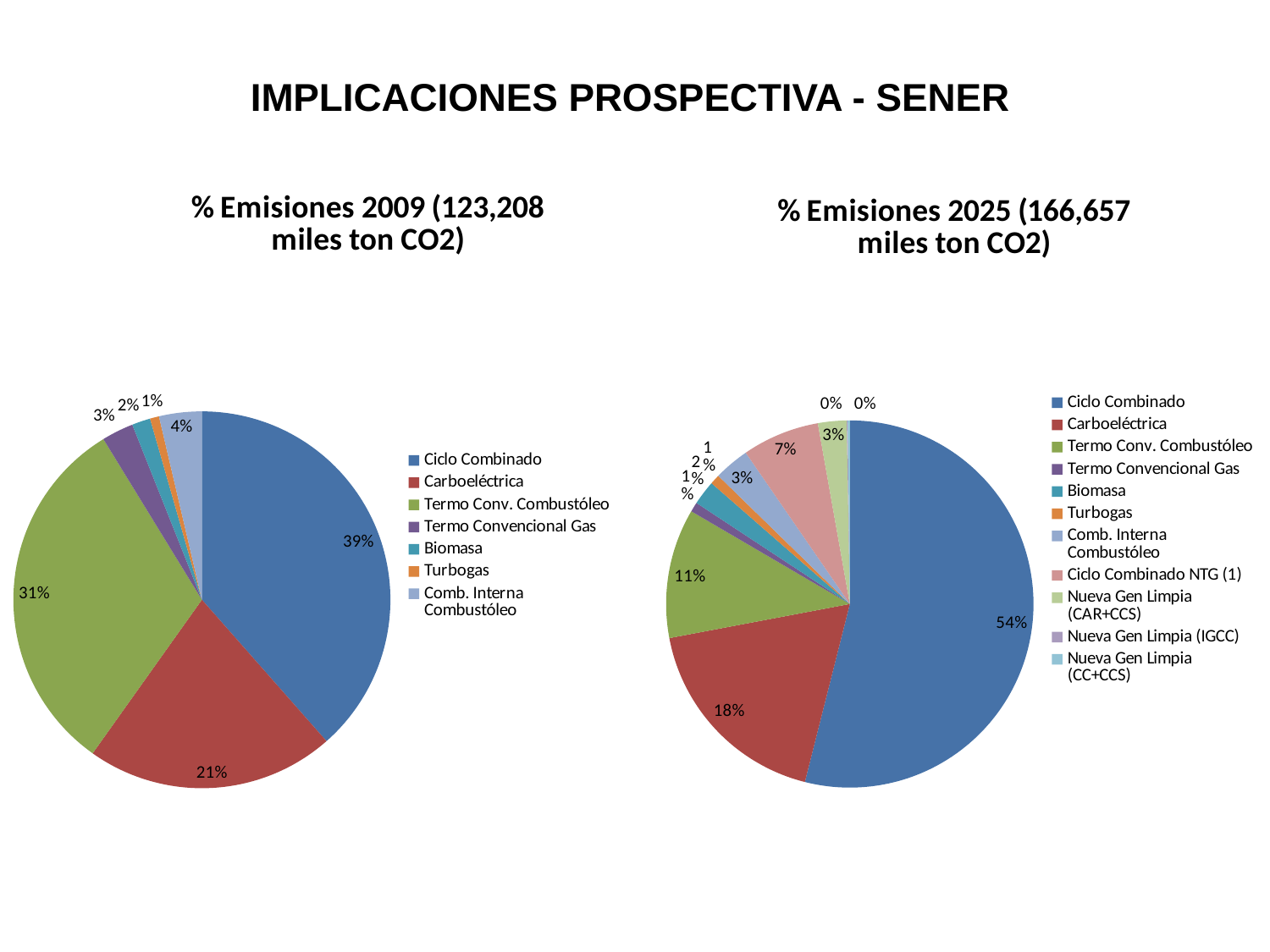
In the '% Emisiones 2009' pie chart, what share does Ciclo Combinado have? 39% In the '% Emisiones 2025' pie chart, what share does Ciclo Combinado NTG (1) have? 7% In the '% Emisiones 2025' pie chart, what share does Carboeléctrica have? 18% In the '% Emisiones 2009' pie chart, which category has the largest share? Ciclo Combinado What type of chart is used on the left side of the slide? Pie chart In the '% Emisiones 2025' pie chart, which is larger: the share of Carboeléctrica or the share of Termo Conv. Combustóleo? Carboeléctrica How many entries does the legend of the '% Emisiones 2025' pie chart list? 11 In the '% Emisiones 2009' pie chart, which category has the smallest share? Turbogas In the '% Emisiones 2009' pie chart, what share does Termo Conv. Combustóleo have? 31% In the '% Emisiones 2025' pie chart, what share does Ciclo Combinado have? 54% In the '% Emisiones 2009' pie chart, what is the difference between the shares of Ciclo Combinado and Carboeléctrica? 18% In the '% Emisiones 2025' pie chart, which category has the largest share? Ciclo Combinado